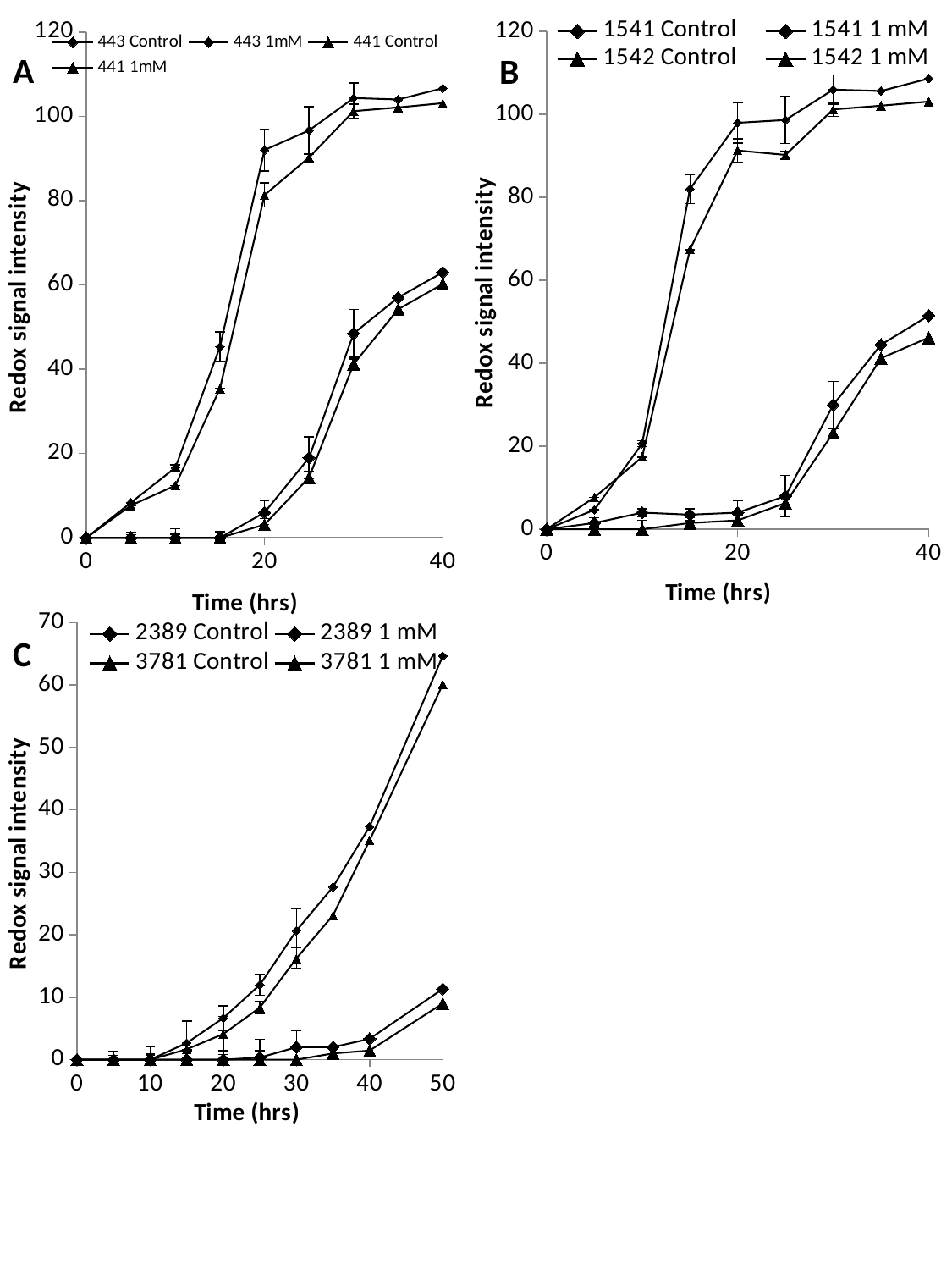
In chart B, is the highest plotted value at 40 hrs greater or less than 100? greater What kind of chart is chart A? line chart How many charts are shown on the slide? 3 In chart C, is the lowest plotted value at 50 hrs greater or less than 20? less In chart C, is the highest plotted value at 50 hrs greater or less than 60? greater What is the x-axis title of chart C? Time (hrs) In chart C, do the plotted values generally rise or fall as time increases? rise How many series does the legend of chart B list? 4 How many series does the legend of chart A list? 4 How many series does the legend of chart C list? 4 What is the y-axis title of chart B? Redox signal intensity